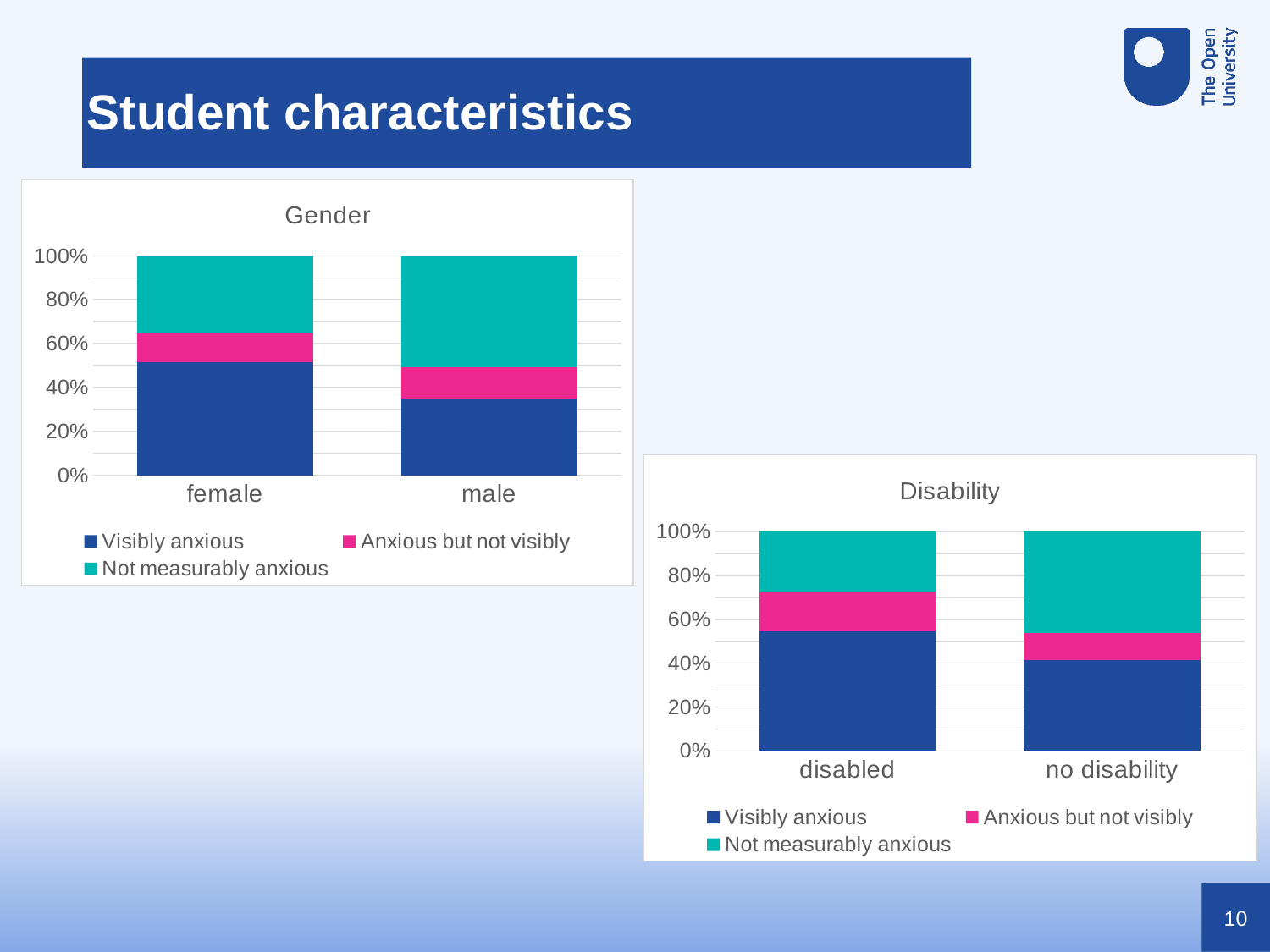
How many categories are shown on the x axis of the Gender chart? 2 In the Disability chart, what is the total of the stacked bar for disabled? 100% In the Gender chart, which category has the larger Visibly anxious share, female or male? female In the Gender chart, is the Visibly anxious value for female greater or less than 40%? greater In the Gender chart, is the Visibly anxious value for male greater or less than 40%? less In the Disability chart, which category has the larger Visibly anxious share, disabled or no disability? disabled In the Disability chart, is the Visibly anxious value for disabled greater or less than 40%? greater How many series does the legend of the Disability chart list? 3 What kind of chart is the Gender chart? stacked bar chart What is the title of the chart on the right of the slide? Disability In the Gender chart, which category has the larger Not measurably anxious share, female or male? male